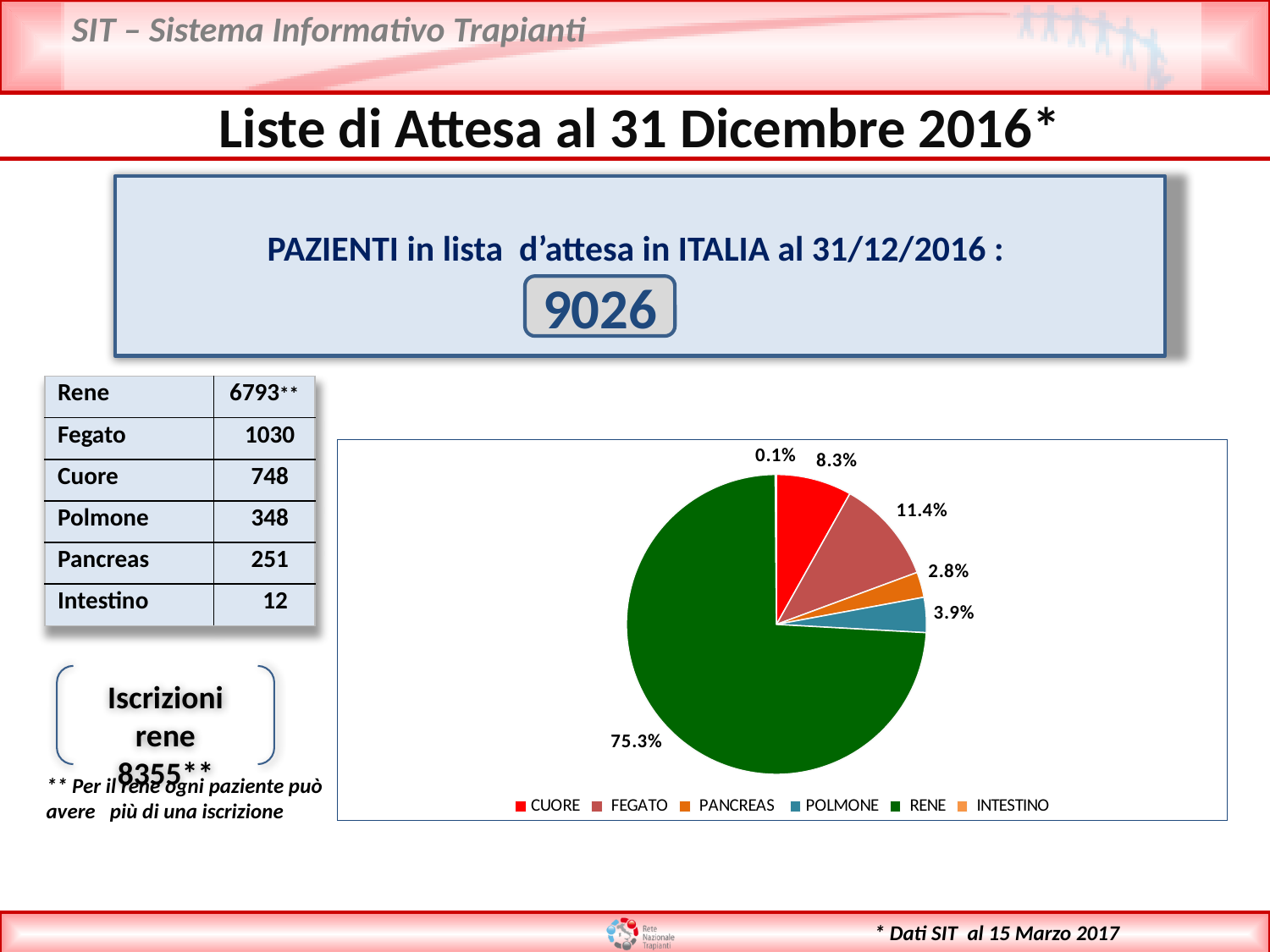
What type of chart is shown on the slide? pie chart What percentage of the pie chart does CUORE represent? 8.3% What percentage of the pie chart does FEGATO represent? 11.4% What colour is the RENE slice in the pie chart? green Which category has the largest slice in the pie chart? RENE Which category has the smallest slice in the pie chart? INTESTINO What percentage of the pie chart does PANCREAS represent? 2.8% What percentage of the pie chart does POLMONE represent? 3.9% How many categories does the pie chart legend list? 6 Which slice is larger in the pie chart, CUORE or FEGATO? FEGATO What is the difference in percentage points between the RENE slice and the FEGATO slice? 63.9 What percentage of the pie chart does RENE represent? 75.3%